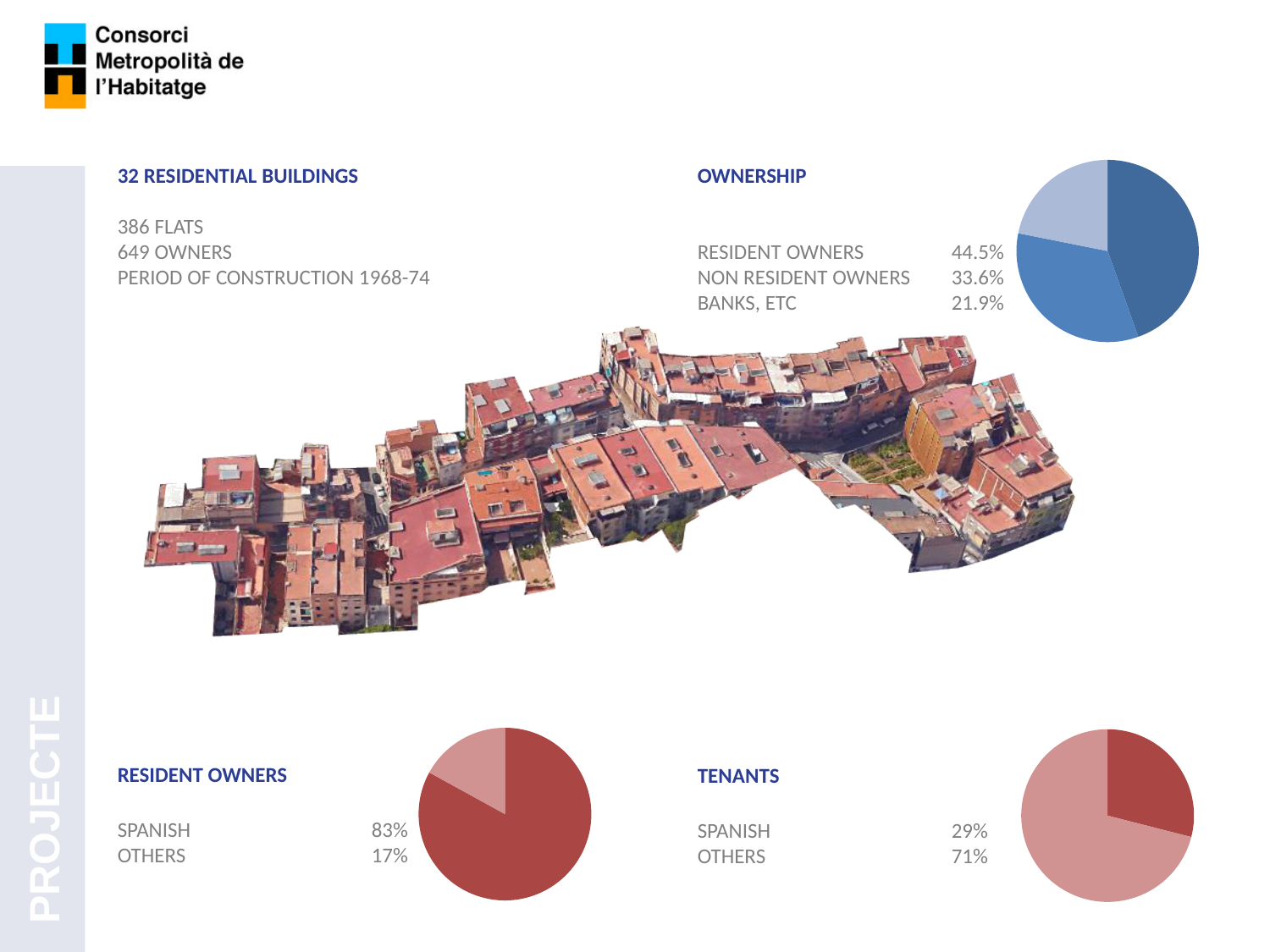
In the Resident Owners pie chart, which is larger, Spanish or Others? Spanish In the Ownership pie chart, what share is held by resident owners? 44.5% In the Resident Owners pie chart, what share is Spanish? 83% In the Tenants pie chart, what is the difference between the Others share and the Spanish share? 42% In the Ownership pie chart, which category has the largest share? Resident owners In the Tenants pie chart, what share is Others? 71% In the Ownership pie chart, which category has the smallest share? Banks, etc How many pie charts are shown on the slide? 3 In the Ownership pie chart, what is the difference between the resident owners share and the non resident owners share? 10.9% What type of chart is used for the Tenants data? Pie chart In the Ownership pie chart, what share is held by banks, etc? 21.9% How many categories does the Ownership pie chart show? 3